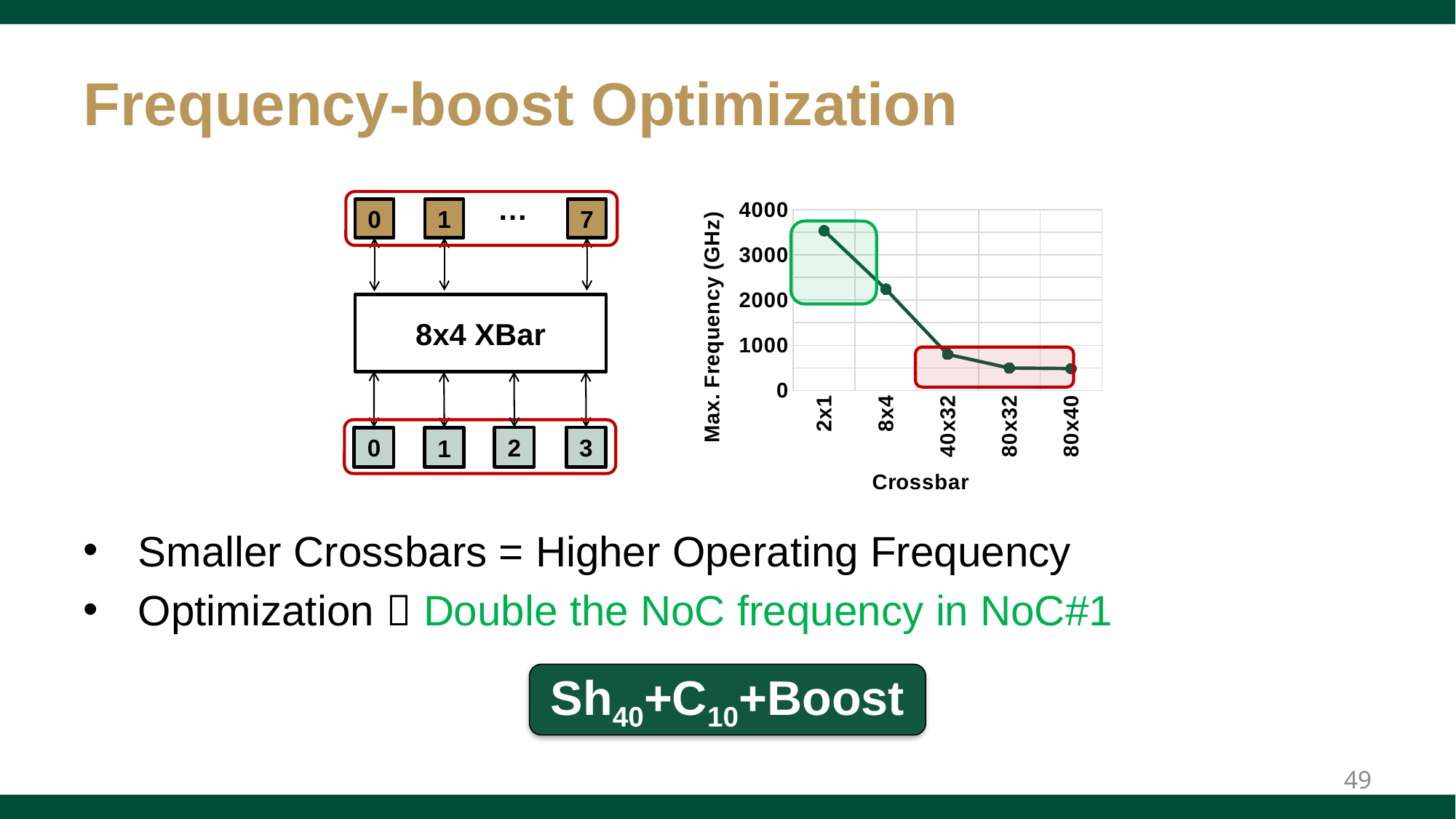
Is the maximum frequency for the 80x40 crossbar greater or less than 1000? less What is the title of the y axis of the chart? Max. Frequency (GHz) What kind of chart is shown on the slide? line chart Which has a higher maximum frequency, the 8x4 crossbar or the 40x32 crossbar? 8x4 Is the maximum frequency for the 8x4 crossbar greater or less than 2000? greater Which has a higher maximum frequency, the 2x1 crossbar or the 80x32 crossbar? 2x1 Do the maximum frequency values rise or fall as the crossbar size increases along the x axis? fall How many crossbar categories are plotted on the x axis of the chart? 5 Is the maximum frequency for the 2x1 crossbar greater or less than 3000? greater Which crossbar has the highest maximum frequency in the chart? 2x1 What is the title of the x axis of the chart? Crossbar